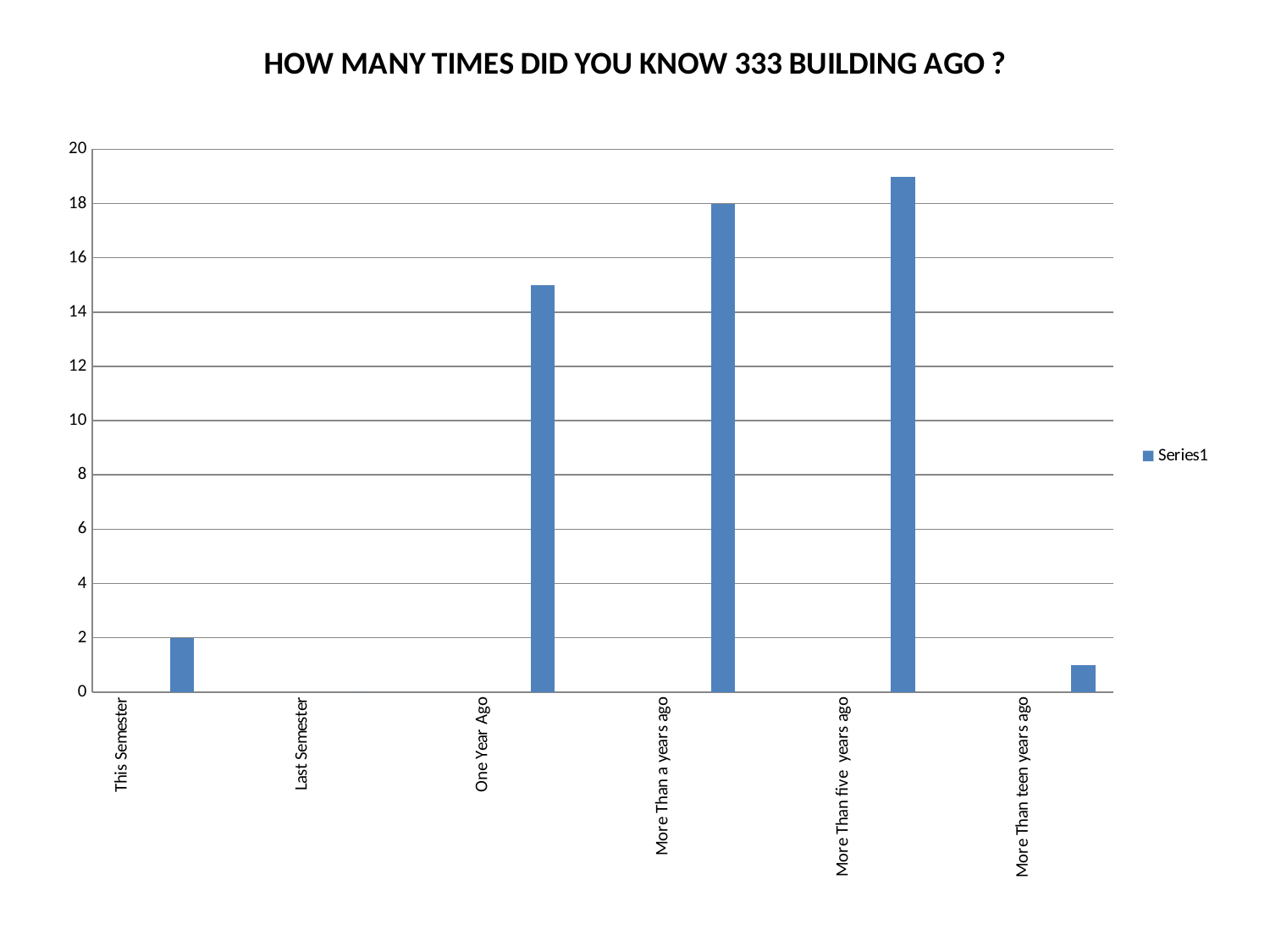
What is the value for More Than a years ago? 18 Which category has the highest value? More Than five years ago How many categories are shown on the x axis? 6 Is the value for One Year Ago greater or less than 14? greater What is the value for Last Semester? 0 What is the value for This Semester? 2 What is the difference between the values for More Than a years ago and This Semester? 16 How many series does the legend list? 1 Which category has the lowest value? Last Semester What kind of chart is shown on the slide? bar chart Which is larger, the value for One Year Ago or the value for More Than a years ago? More Than a years ago Is the value for More Than teen years ago greater or less than 2? less